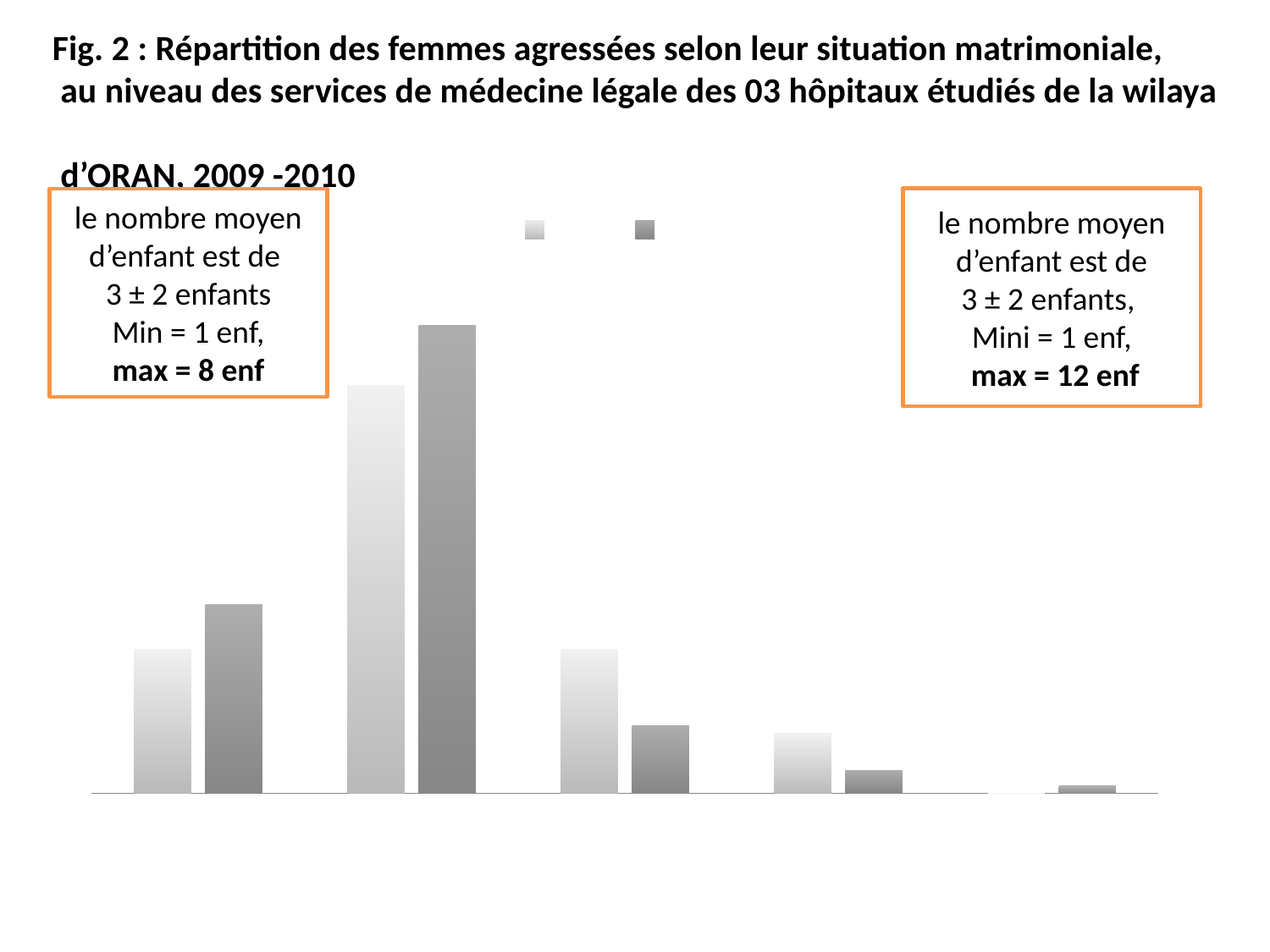
How many series does the chart's legend show? 2 In the third group from the left, which bar is taller, the light grey one or the dark grey one? the light grey one In the first group from the left, which bar is taller, the light grey one or the dark grey one? the dark grey one What kind of chart is shown on the slide? bar chart From the second group onward, do the bar heights rise or fall moving to the right? fall Which group of bars, counted from the left, has the lowest values? the fifth group In the second group from the left, which bar is taller, the light grey one or the dark grey one? the dark grey one According to the annotation box on the right, what is the maximum number of children? max = 12 enf How many groups of bars are plotted along the x axis? 5 Which group of bars, counted from the left, has the tallest bars? the second group According to the annotation box on the left, what is the maximum number of children? max = 8 enf